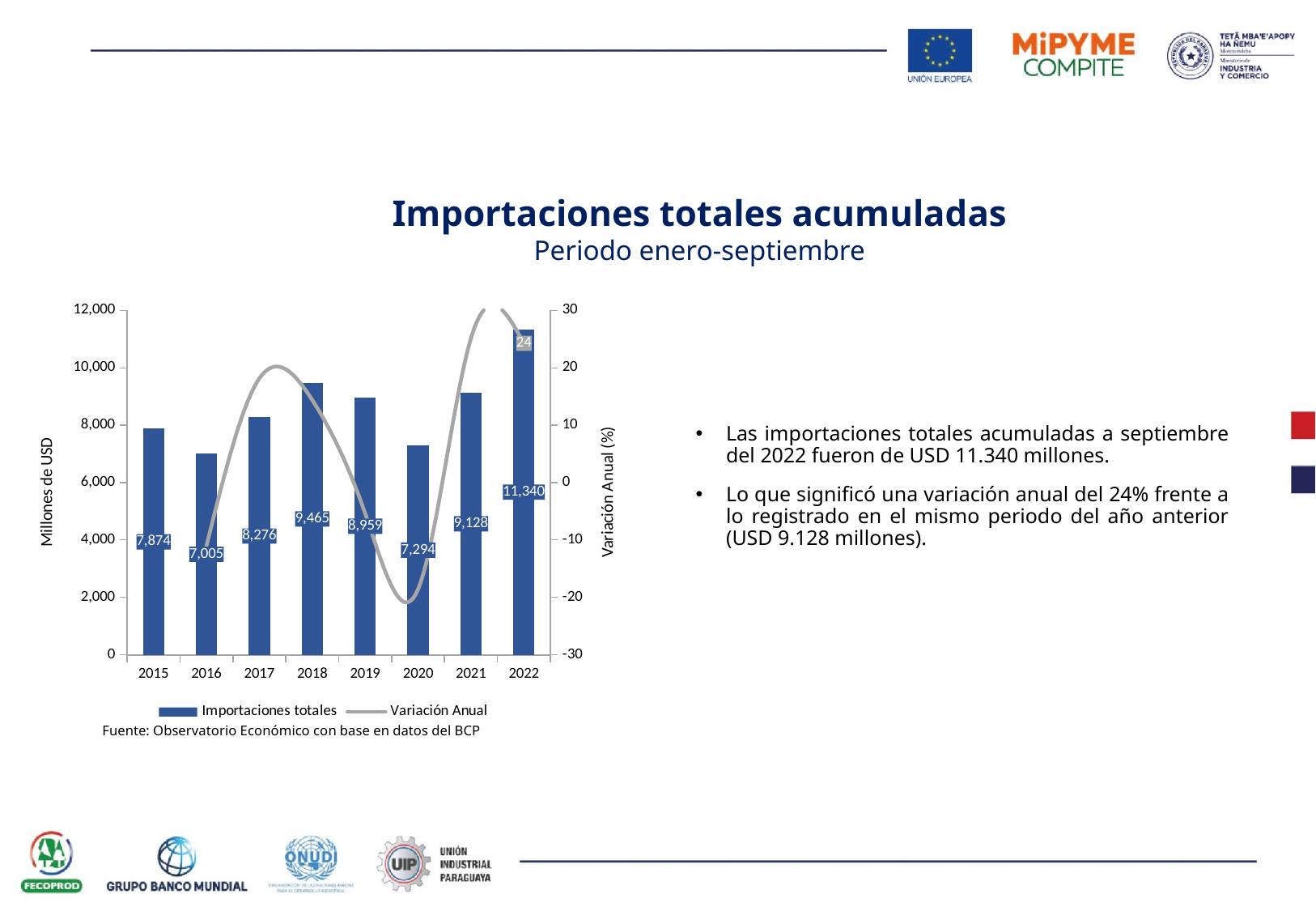
What is the value of Importaciones totales for 2016? 7,005 What is the difference between Importaciones totales in 2022 and 2021? 2,212 Is the Variación Anual value for 2020 greater or less than -10? less Which year has the lowest Importaciones totales? 2016 What is the value of Importaciones totales for 2022? 11,340 Which is larger, Importaciones totales in 2019 or in 2020? 2019 What is the value of Importaciones totales for 2018? 9,465 Which year has the highest Importaciones totales? 2022 What is the Variación Anual value labelled for 2022? 24 How many years are shown on the x axis? 8 What is the title of the chart? Importaciones totales acumuladas How many series does the legend list? 2